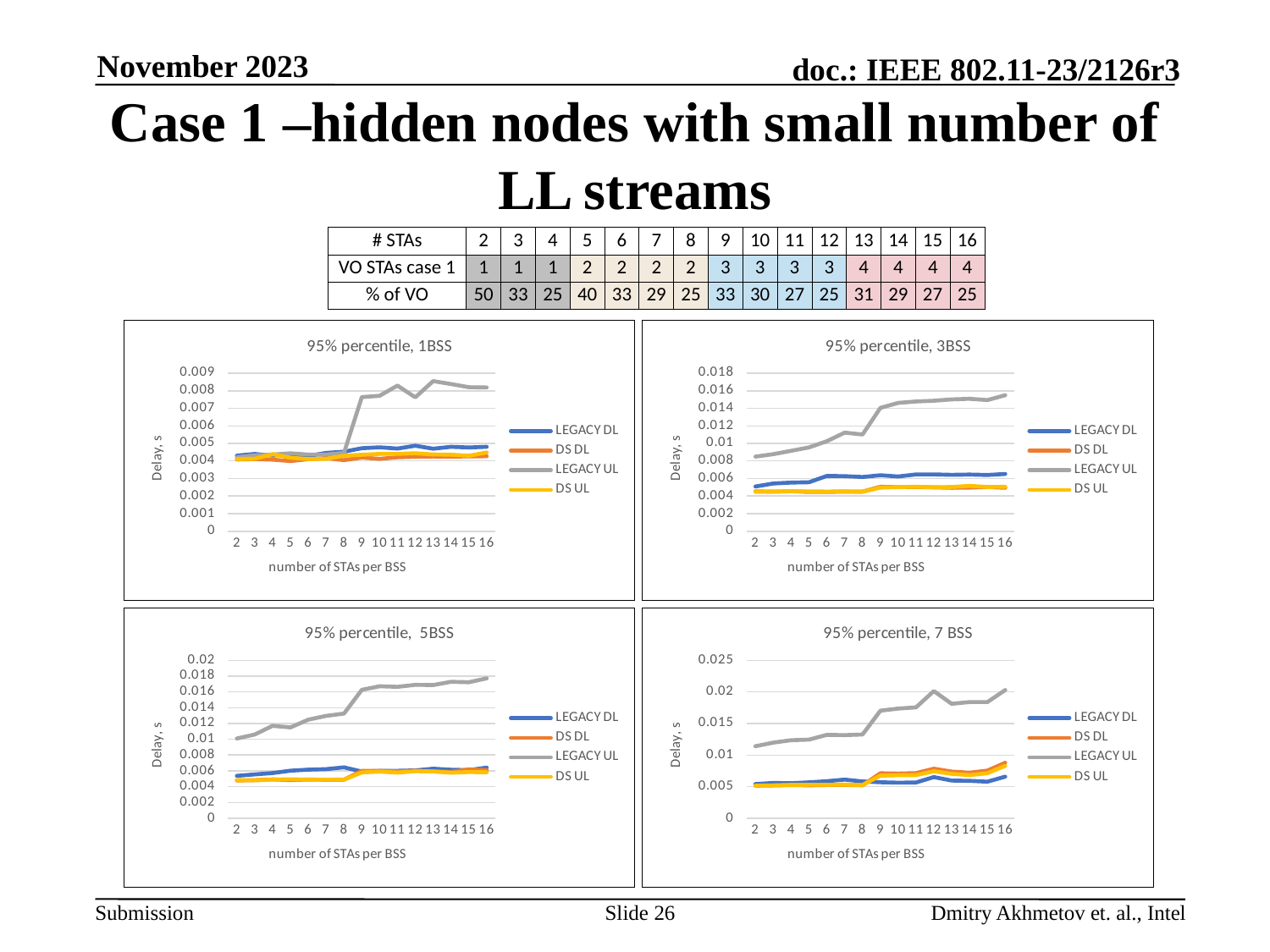
In the "95% percentile, 7 BSS" chart, does the LEGACY UL delay generally rise or fall as the number of STAs per BSS increases? rise How many values of number of STAs per BSS are plotted along the x axis of the "95% percentile, 5BSS" chart? 15 What is the x-axis title of the "95% percentile, 7 BSS" chart? number of STAs per BSS In the "95% percentile, 3BSS" chart, is the LEGACY UL value at 16 STAs per BSS greater or less than 0.014? greater In the "95% percentile, 1BSS" chart, is the LEGACY UL value at 16 STAs per BSS greater or less than 0.007? greater What type of chart is the "95% percentile, 1BSS" chart? line chart In the "95% percentile, 1BSS" chart, which series has the highest delay at 16 STAs per BSS? LEGACY UL In the "95% percentile, 7 BSS" chart, which is larger at 16 STAs per BSS: LEGACY UL or DS UL? LEGACY UL How many series does the legend of the "95% percentile, 3BSS" chart list? 4 In the "95% percentile, 3BSS" chart, is the LEGACY DL value at 16 STAs per BSS greater or less than 0.008? less How many charts are shown on the slide? 4